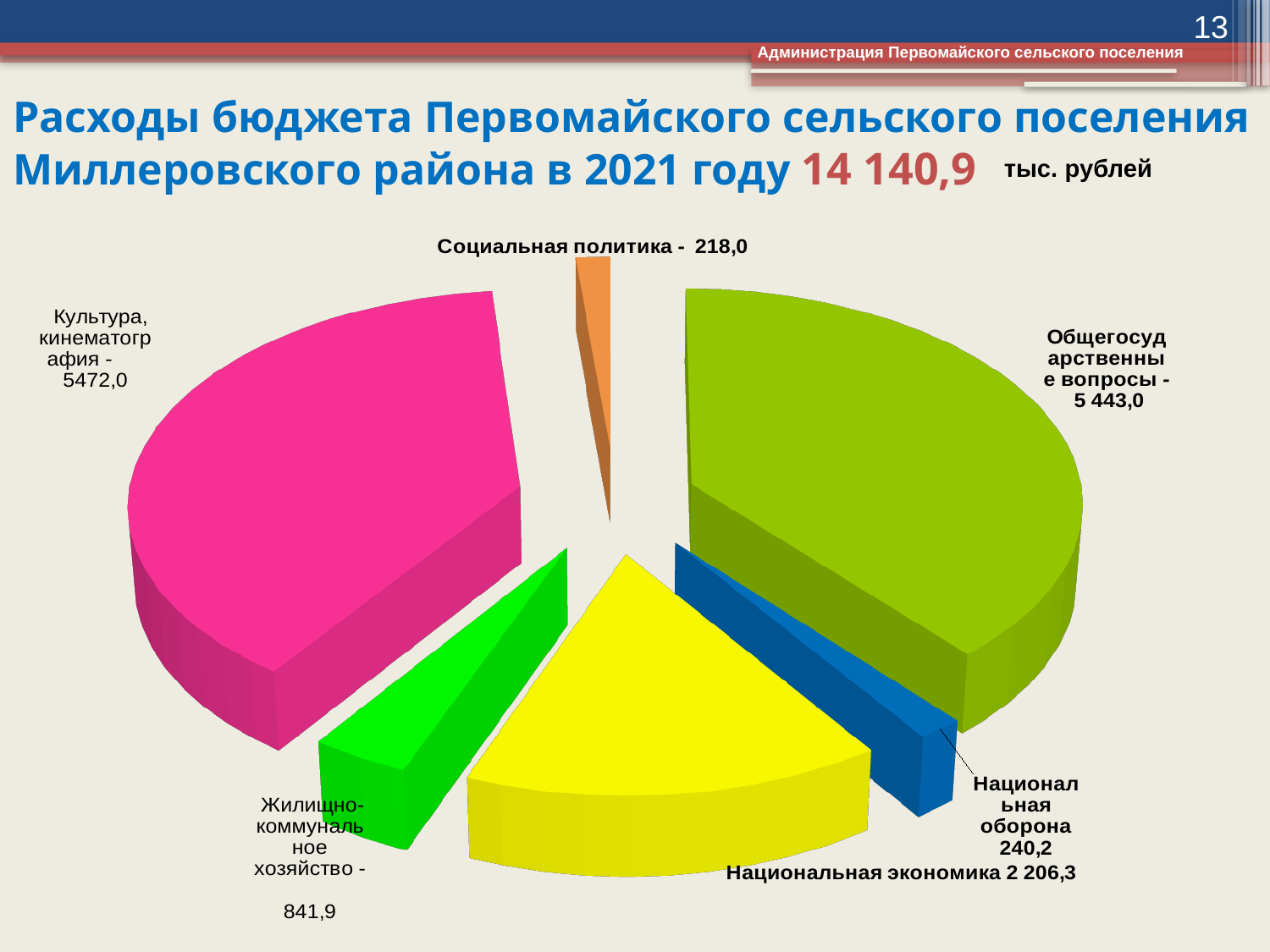
What is the value for Национальная экономика? 2 206,3 What is the value for Общегосударственные вопросы? 5 443,0 What is the value for Жилищно-коммунальное хозяйство? 841,9 Which category has the largest value in the pie chart? Культура, кинематография How many slices does the pie chart have? 6 Which category has the smallest value in the pie chart? Социальная политика What total budget expenditure amount is stated in the slide title? 14 140,9 тыс. рублей What is the difference between Национальная экономика and Жилищно-коммунальное хозяйство? 1 364,4 Which is larger, Национальная оборона or Социальная политика? Национальная оборона What kind of chart is shown on the slide? Pie chart What is the value for Национальная оборона? 240,2 What is the value for Социальная политика? 218,0